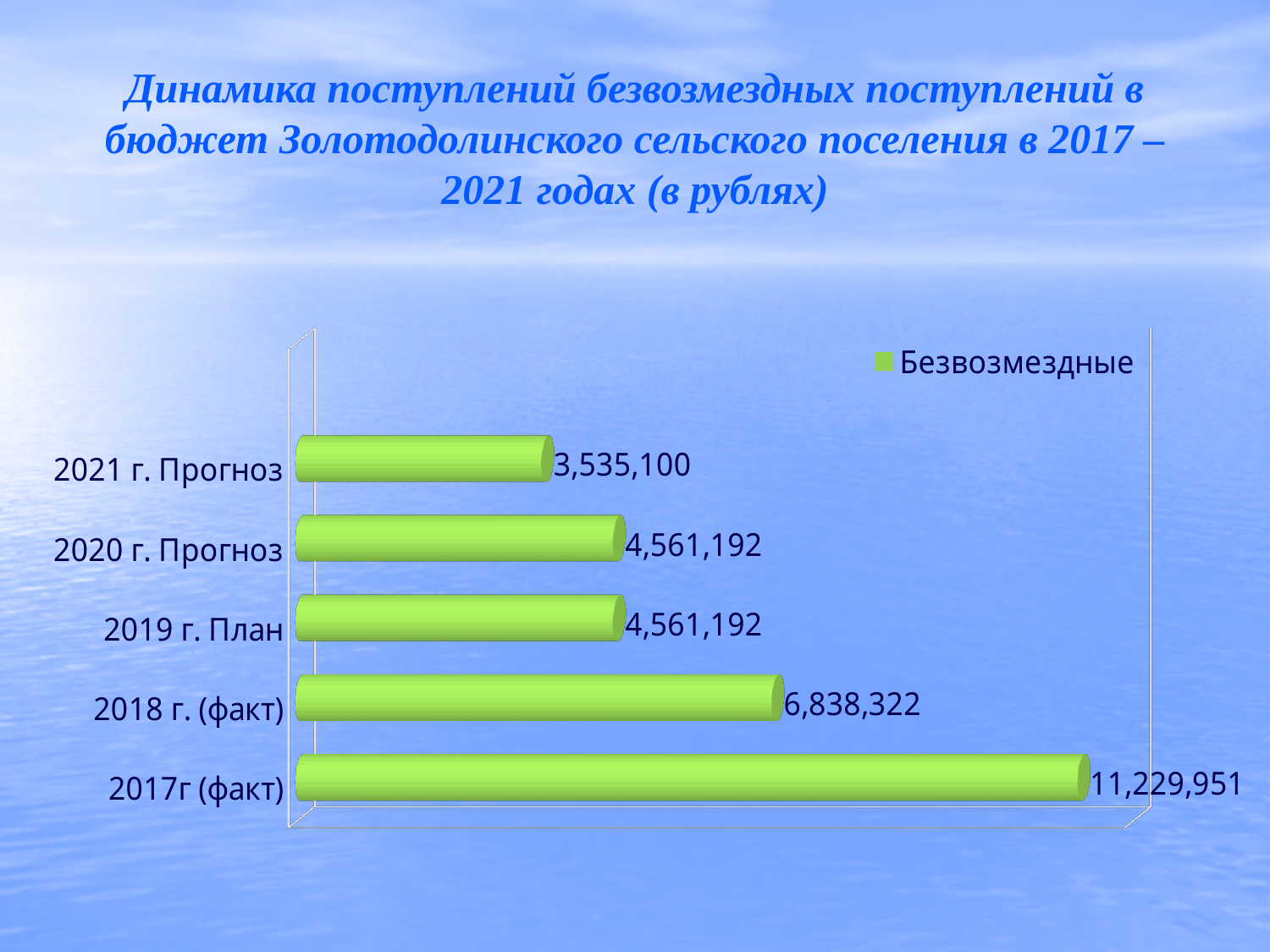
Which is larger, the value for 2018 г. (факт) or the value for 2019 г. План? 2018 г. (факт) What is the value for 2017г (факт)? 11,229,951 What is the value for 2018 г. (факт)? 6,838,322 Which category has the highest value? 2017г (факт) What is the value for 2019 г. План? 4,561,192 What is the difference between the values for 2020 г. Прогноз and 2021 г. Прогноз? 1,026,092 How many categories are shown in the chart? 5 What is the value for 2021 г. Прогноз? 3,535,100 How many series does the legend list? 1 What is the difference between the values for 2017г (факт) and 2018 г. (факт)? 4,391,629 What kind of chart is shown on the slide? Bar chart Which category has the lowest value? 2021 г. Прогноз